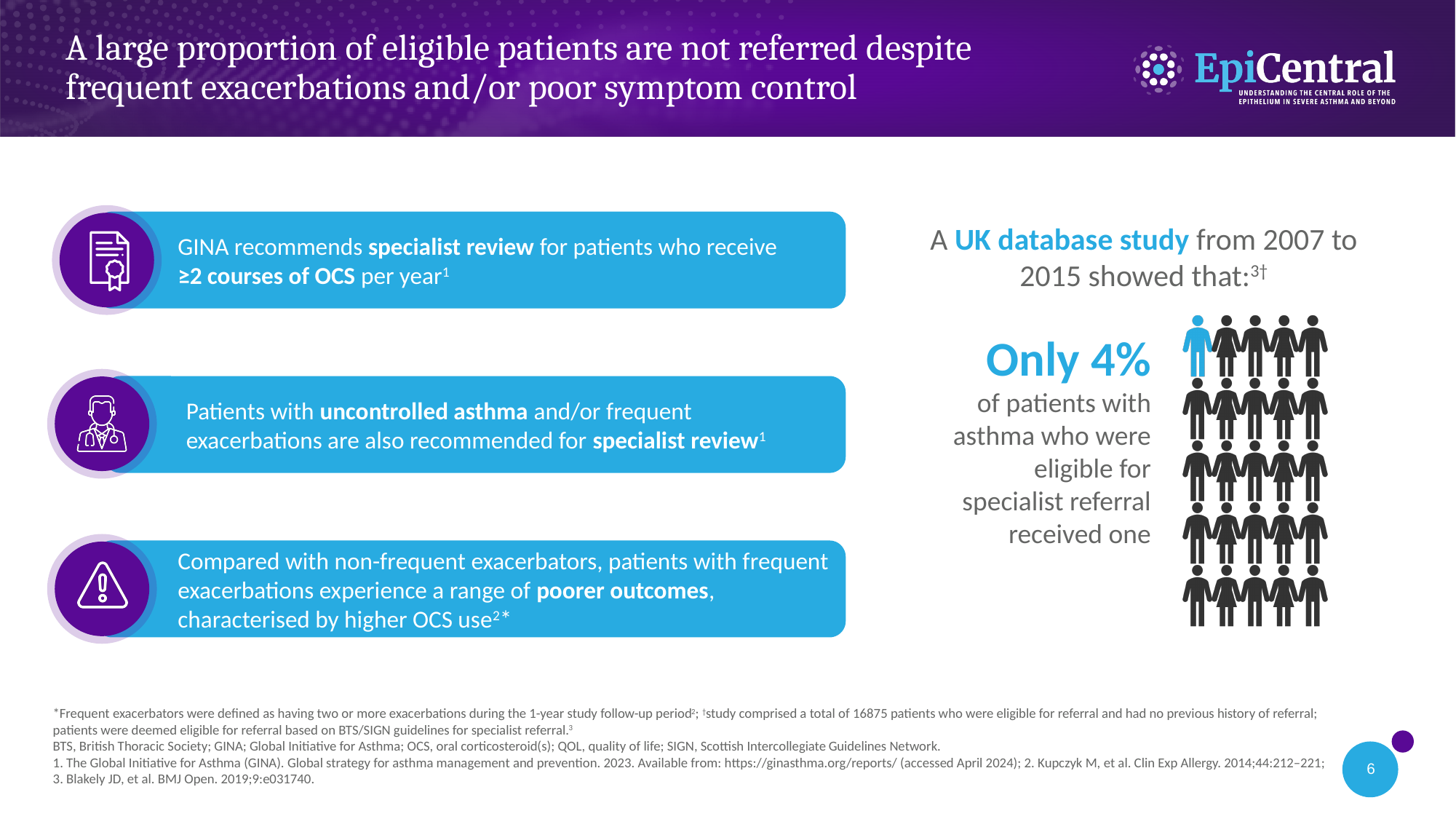
In the pictogram on the right of the slide, how many person icons are highlighted in blue? 1 What years does the UK database study shown in the pictogram on the right of the slide cover? 2007 to 2015 According to the pictogram on the right of the slide, what percentage of patients with asthma who were eligible for specialist referral received one? 4% What kind of chart is shown on the right of the slide? Pictogram (icon array of people) How many person icons in total are shown in the pictogram on the right of the slide? 25 In the pictogram on the right of the slide, what colour is used for the icon representing patients who received a specialist referral? Blue